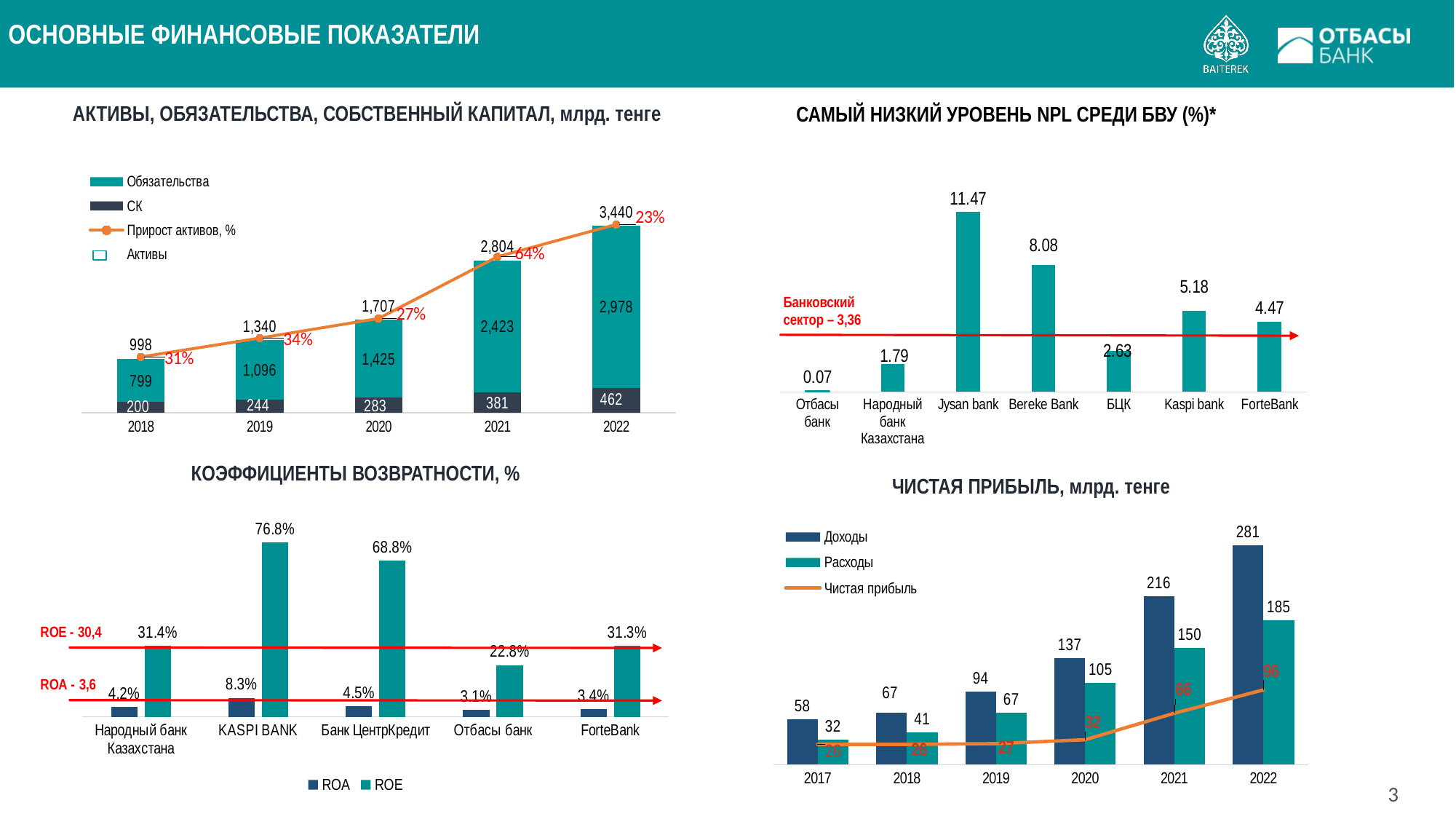
In the chart 'САМЫЙ НИЗКИЙ УРОВЕНЬ NPL СРЕДИ БВУ (%)*', which bank has the highest value? Jysan bank In the chart 'АКТИВЫ, ОБЯЗАТЕЛЬСТВА, СОБСТВЕННЫЙ КАПИТАЛ, млрд. тенге', how many entries does the legend list? 4 In the chart 'АКТИВЫ, ОБЯЗАТЕЛЬСТВА, СОБСТВЕННЫЙ КАПИТАЛ, млрд. тенге', what is the value of Обязательства for 2021? 2,423 In the chart 'САМЫЙ НИЗКИЙ УРОВЕНЬ NPL СРЕДИ БВУ (%)*', what is the value for Kaspi bank? 5.18 In the chart 'КОЭФФИЦИЕНТЫ ВОЗВРАТНОСТИ, %', which bank has the lowest ROA? Отбасы банк In the chart 'КОЭФФИЦИЕНТЫ ВОЗВРАТНОСТИ, %', what is the ROE value for Банк ЦентрКредит? 68.8% In the chart 'САМЫЙ НИЗКИЙ УРОВЕНЬ NPL СРЕДИ БВУ (%)*', how many banks are shown? 7 In the chart 'ЧИСТАЯ ПРИБЫЛЬ, млрд. тенге', do the Доходы values rise or fall from 2017 to 2022? rise In the chart 'ЧИСТАЯ ПРИБЫЛЬ, млрд. тенге', what is the difference between Доходы and Расходы in 2022? 96 In the chart 'ЧИСТАЯ ПРИБЫЛЬ, млрд. тенге', what is the Чистая прибыль value for 2021? 66 In the chart 'АКТИВЫ, ОБЯЗАТЕЛЬСТВА, СОБСТВЕННЫЙ КАПИТАЛ, млрд. тенге', what is the Прирост активов, % value for 2019? 34% In the chart 'АКТИВЫ, ОБЯЗАТЕЛЬСТВА, СОБСТВЕННЫЙ КАПИТАЛ, млрд. тенге', what is the total of the stacked bar for 2022? 3,440